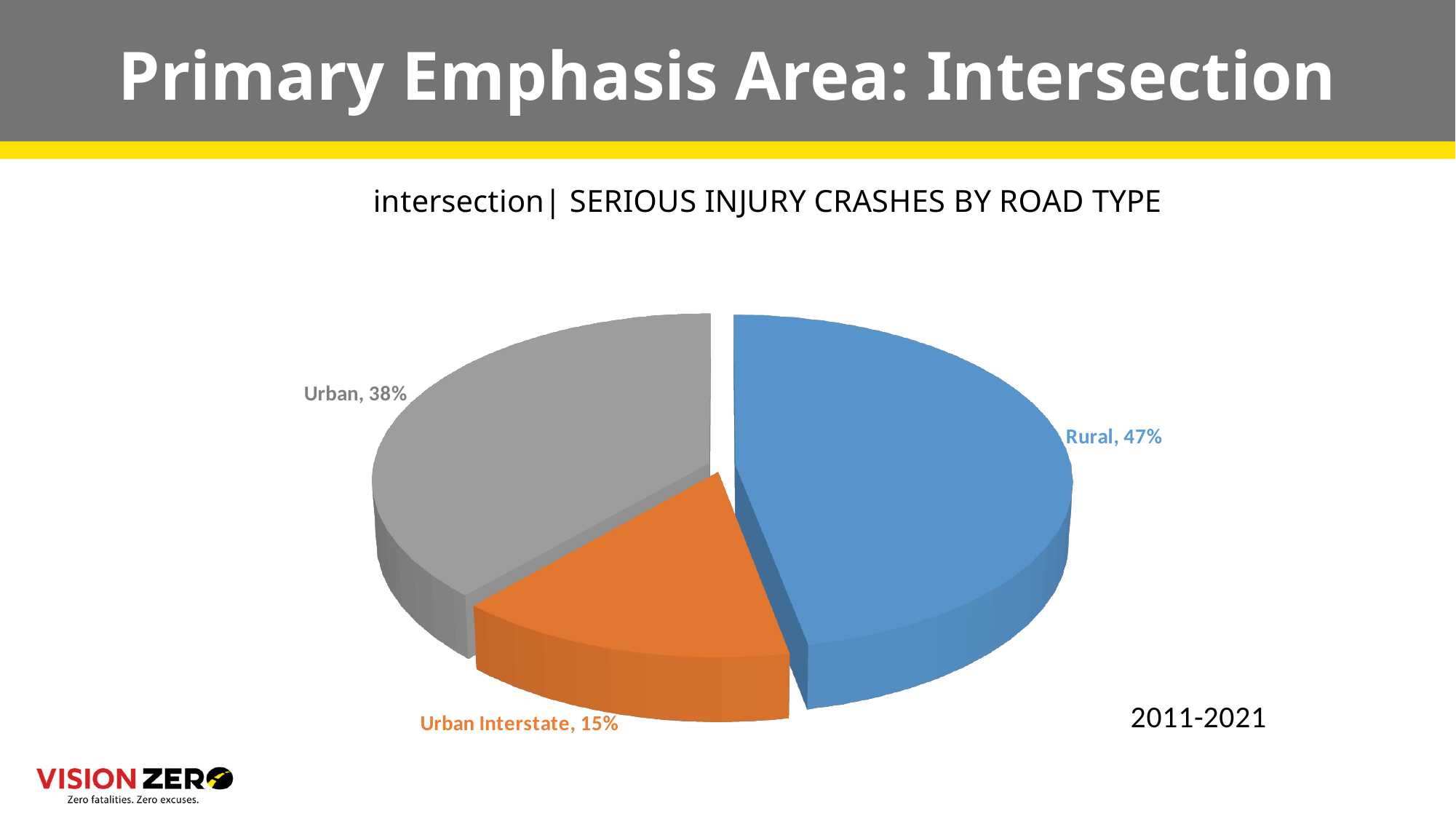
Which road type has the smallest share of intersection serious injury crashes? Urban Interstate What is the title of the chart? intersection| SERIOUS INJURY CRASHES BY ROAD TYPE What share of serious injury crashes at intersections occurred on Urban Interstate roads? 15% What share of serious injury crashes at intersections occurred on Rural roads? 47% What is the difference in percentage points between the Rural and Urban shares? 9 What share of serious injury crashes at intersections occurred on Urban roads? 38% Which has a larger share of intersection serious injury crashes, Urban or Urban Interstate? Urban What is the difference in percentage points between the Urban and Urban Interstate shares? 23 Which road type has the largest share of intersection serious injury crashes? Rural How many road type categories are shown in the pie chart? 3 What kind of chart is shown on the slide? Pie chart What time period does the chart cover? 2011-2021